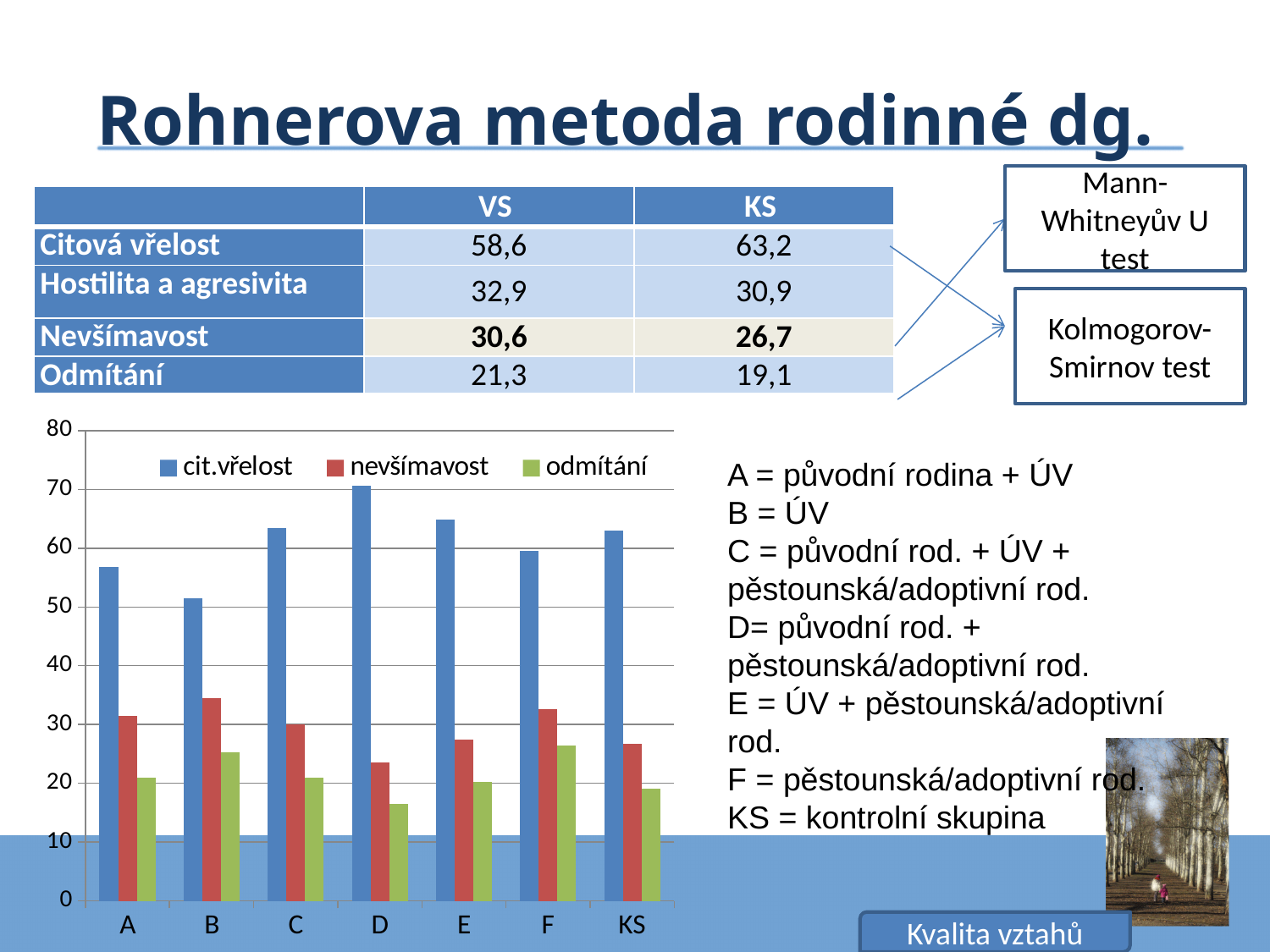
How many series does the chart legend list? 3 Which category has the highest value for nevšímavost? B Which category has the lowest value for nevšímavost? D How many categories are shown on the x axis of the chart? 7 Which category has the lowest value for odmítání? D Which category has the highest value for cit.vřelost? D Which category has the lowest value for cit.vřelost? B Which is larger: cit.vřelost for category C or cit.vřelost for category B? C Is the value for cit.vřelost in category A greater or less than 50? greater Which colour represents the series cit.vřelost in the chart? blue What kind of chart is shown on the slide? bar chart Is the value for odmítání in category D greater or less than 20? less